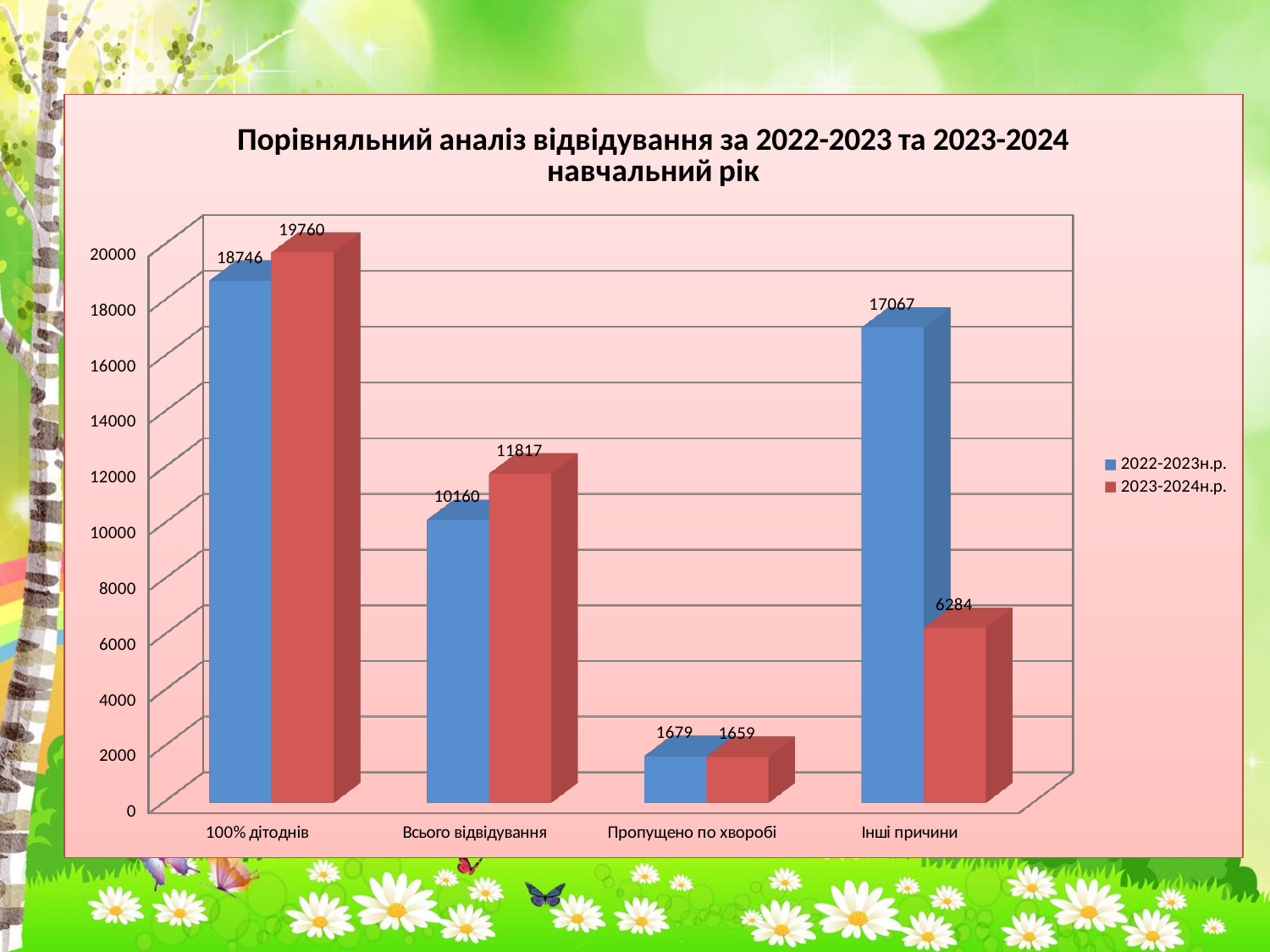
What is the difference between the 2023-2024н.р. and 2022-2023н.р. values for 100% дітоднів? 1014 Which category has the lowest value in the 2022-2023н.р. series? Пропущено по хворобі What is the value for Пропущено по хворобі in the 2022-2023н.р. series? 1679 What is the value for Інші причини in the 2023-2024н.р. series? 6284 How many series does the legend list? 2 What kind of chart is shown on the slide? Bar chart What is the difference between the 2022-2023н.р. and 2023-2024н.р. values for Інші причини? 10783 What is the value for 100% дітоднів in the 2022-2023н.р. series? 18746 What is the value for Всього відвідування in the 2023-2024н.р. series? 11817 How many categories are shown on the x axis? 4 Which category has the highest value in the 2023-2024н.р. series? 100% дітоднів For Всього відвідування, which series has the larger value, 2022-2023н.р. or 2023-2024н.р.? 2023-2024н.р.